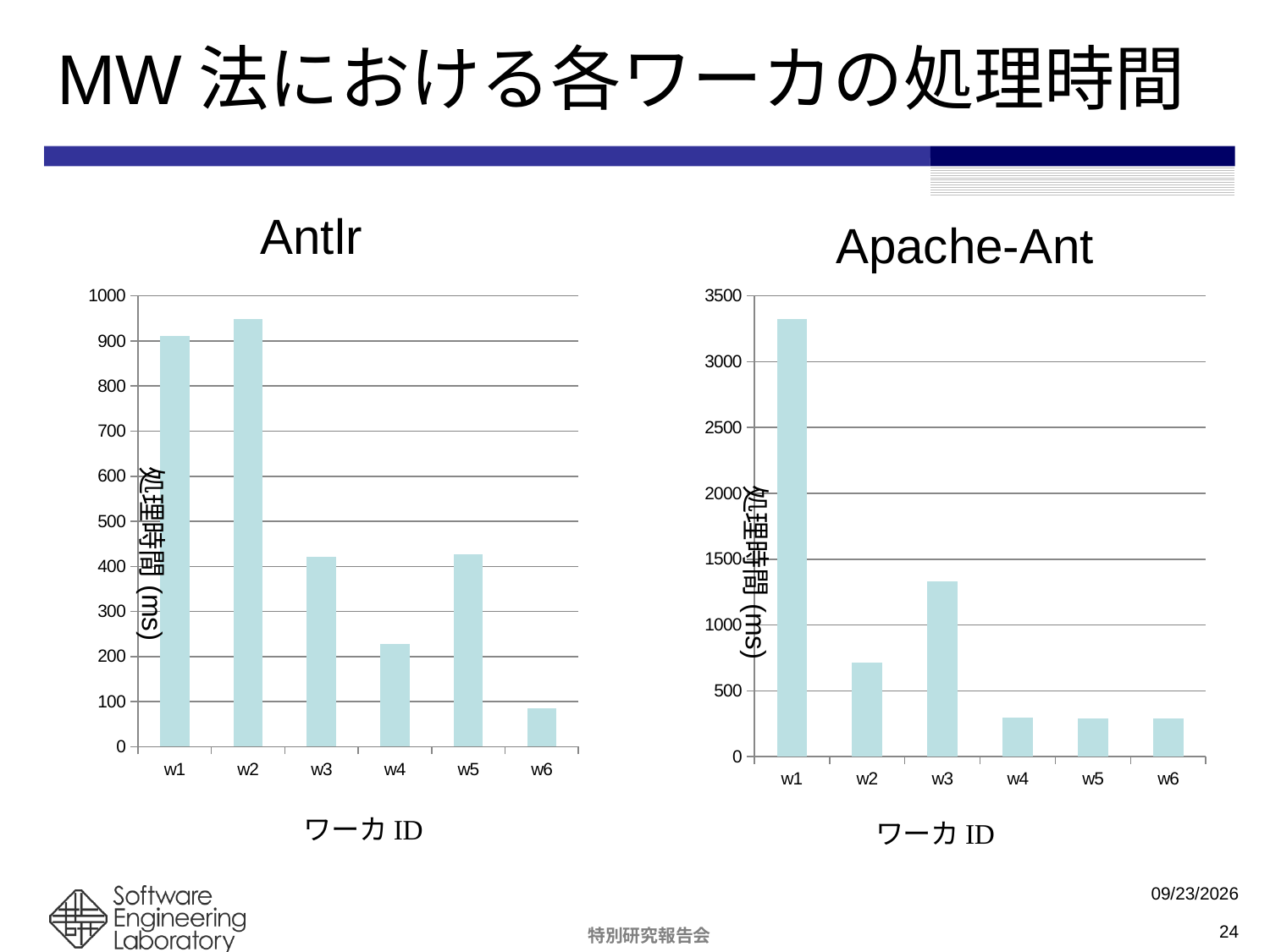
In the Antlr chart, is the value for w1 greater or less than 800? greater In the Apache-Ant chart, which worker has the highest processing time? w1 In the Apache-Ant chart, is the value for w2 greater or less than 1000? less What is the y-axis label of the Antlr chart? 処理時間 (ms) What kind of chart is the Antlr chart? bar chart In the Apache-Ant chart, which is larger, the value for w2 or the value for w3? w3 In the Antlr chart, is the value for w4 greater or less than 200? greater How many workers are shown on the x axis of the Apache-Ant chart? 6 In the Antlr chart, which worker has the lowest processing time? w6